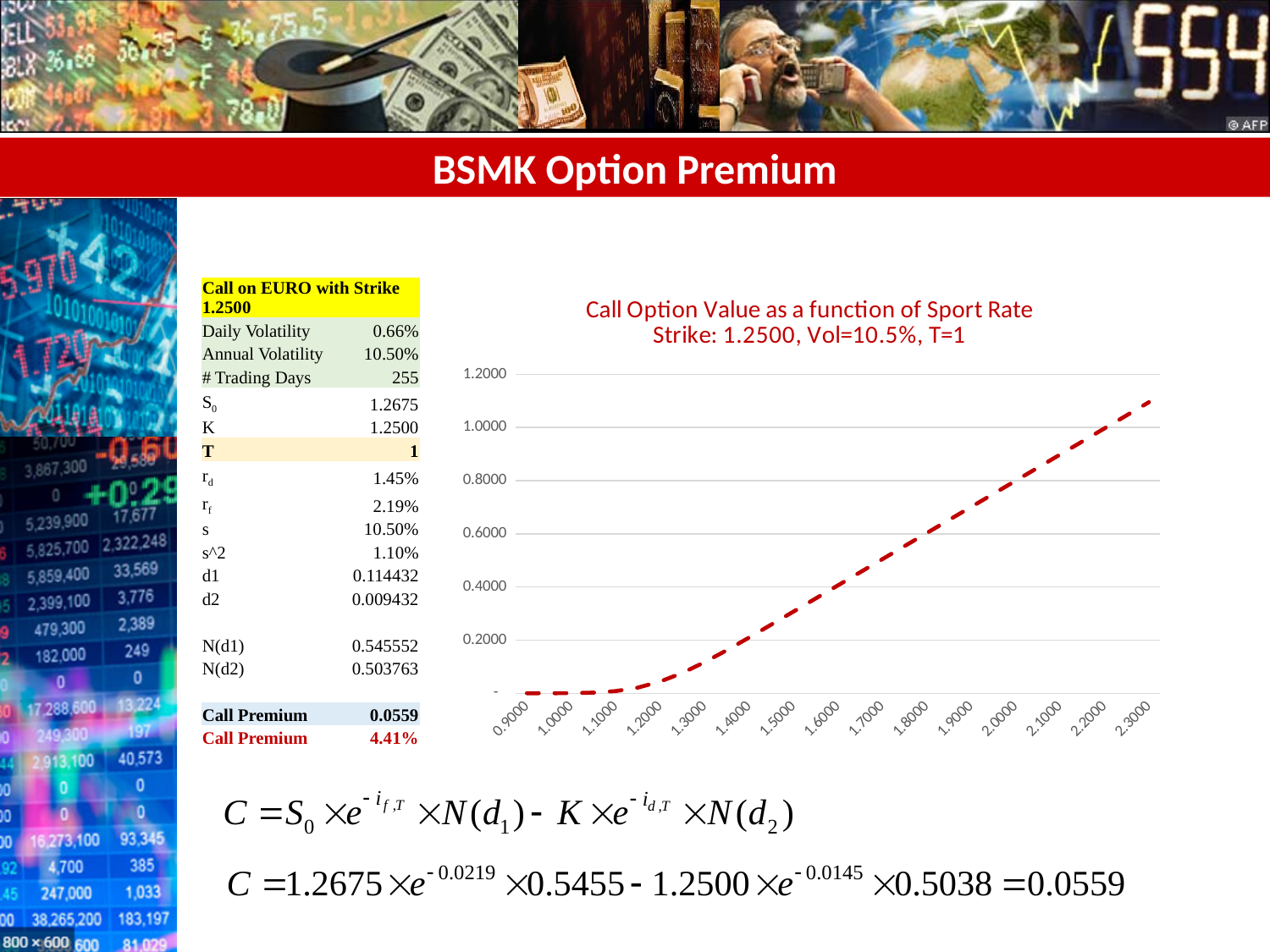
Which spot rate has the larger call option value, 1.6000 or 2.2000? 2.2000 Is the call option value at a spot rate of 1.7000 greater or less than 0.6000? less At which spot rate on the x axis is the call option value highest? 2.3000 Does the call option value rise or fall as the spot rate increases along the x axis? rise How many spot rate points are labelled along the x axis of the chart? 15 Is the call option value at a spot rate of 1.5000 greater or less than 0.4000? less What is the title of the chart? Call Option Value as a function of Sport Rate Strike: 1.2500, Vol=10.5%, T=1 What colour and style is the line plotted on the chart? red dashed line Is the call option value at a spot rate of 2.3000 greater or less than 1.0000? greater What kind of chart is shown on the slide? line chart